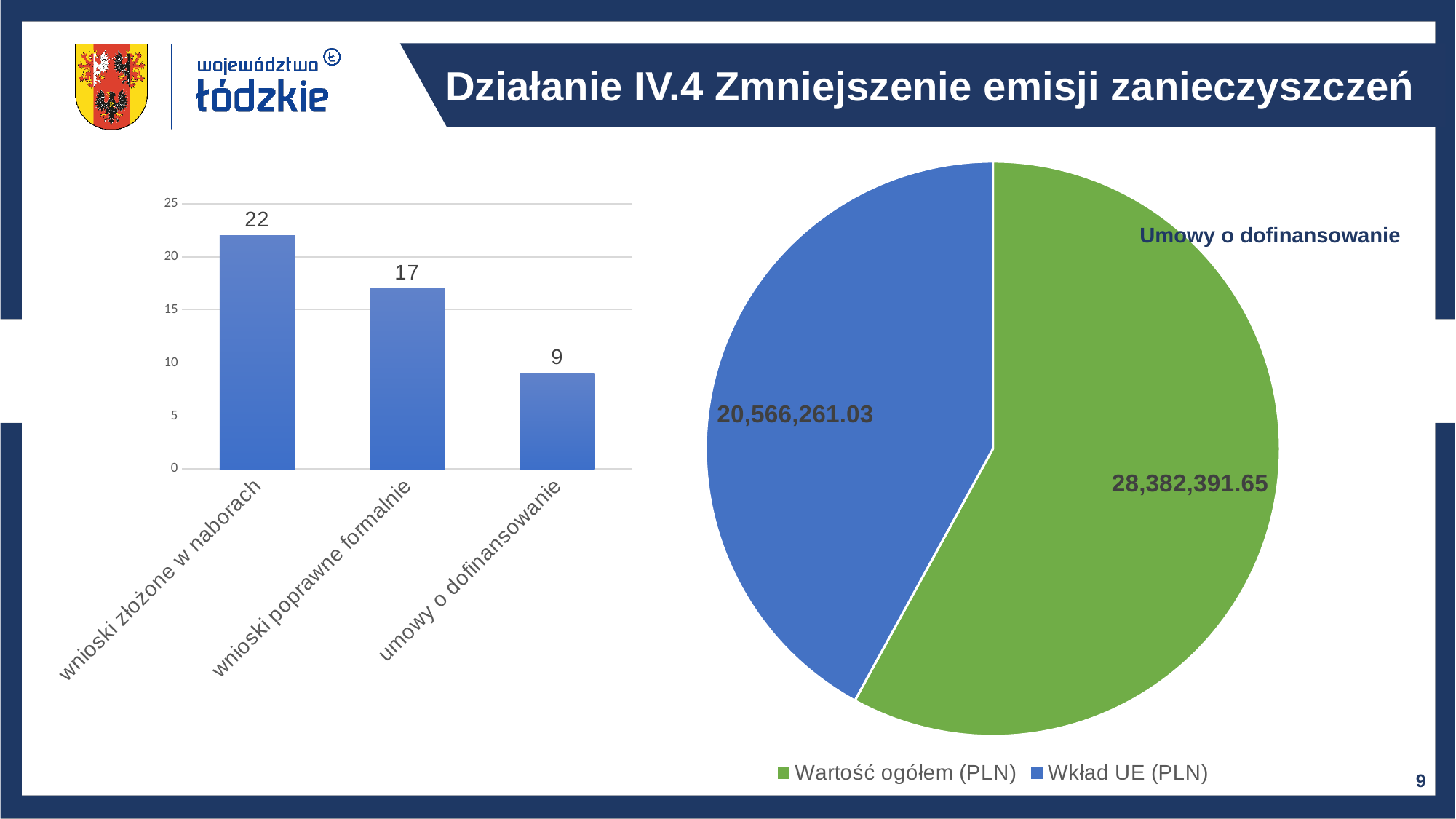
In the bar chart on the left, which category has the highest value? wnioski złożone w naborach In the 'Umowy o dofinansowanie' pie chart, what is the value for 'Wkład UE (PLN)'? 20,566,261.03 In the bar chart on the left, which category has the lowest value? umowy o dofinansowanie In the bar chart on the left, do the values rise or fall from left to right? fall What type of chart is shown on the right side of the slide? pie chart In the bar chart on the left, how many categories are shown? 3 In the bar chart on the left, what is the difference between 'wnioski złożone w naborach' and 'umowy o dofinansowanie'? 13 In the bar chart on the left, what is the value for 'wnioski poprawne formalnie'? 17 In the bar chart on the left, what is the value for 'wnioski złożone w naborach'? 22 In the 'Umowy o dofinansowanie' pie chart, what is the value for 'Wartość ogółem (PLN)'? 28,382,391.65 In the 'Umowy o dofinansowanie' pie chart, which is larger: 'Wartość ogółem (PLN)' or 'Wkład UE (PLN)'? Wartość ogółem (PLN) In the bar chart on the left, what is the value for 'umowy o dofinansowanie'? 9